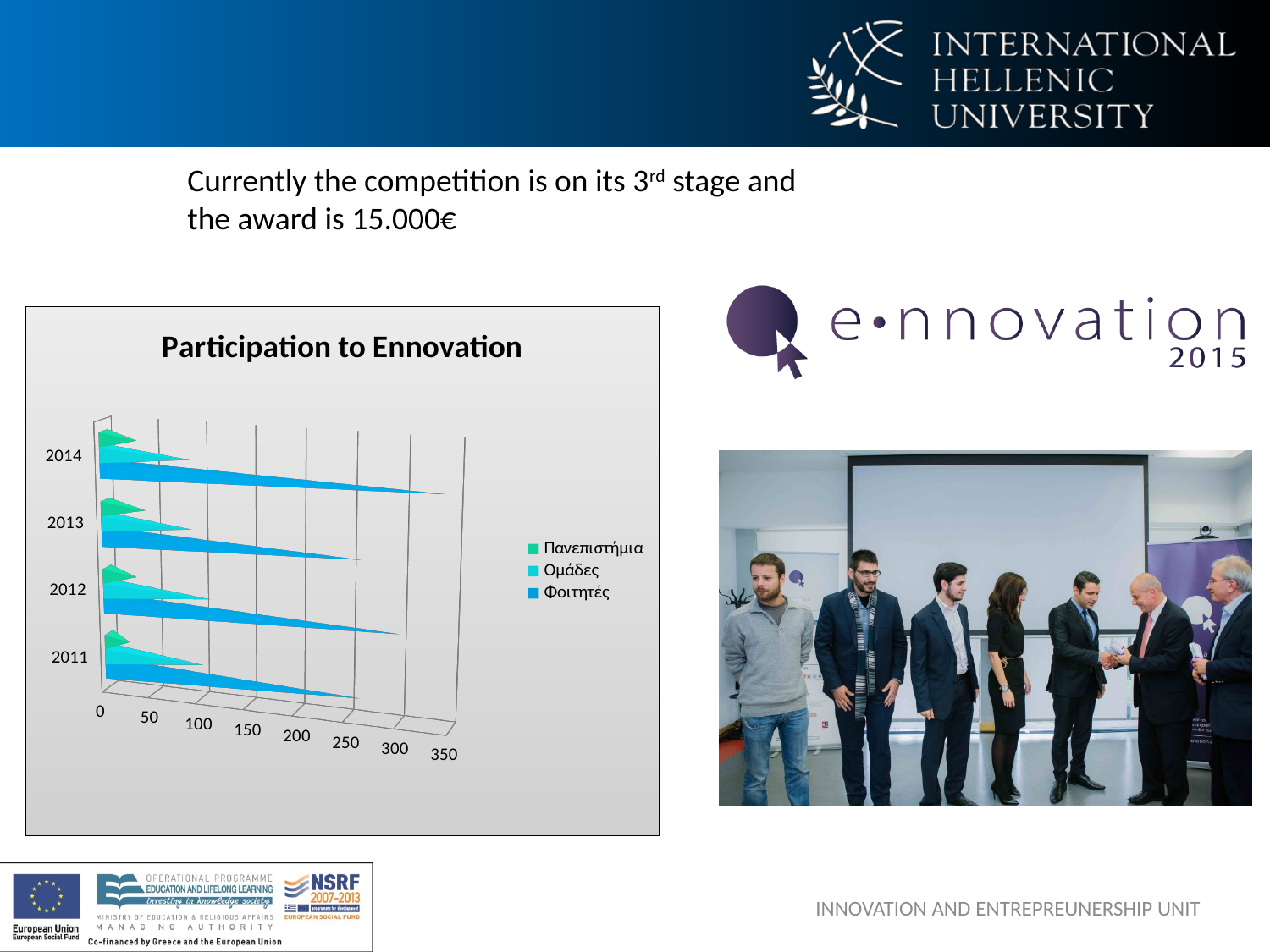
What kind of chart is shown on the slide? bar chart What is the title of the chart? Participation to Ennovation In 2012, which series has the larger value, Φοιτητές or Πανεπιστήμια? Φοιτητές Is the Φοιτητές value for 2011 greater or less than 300? less Is the Πανεπιστήμια value for 2014 greater or less than 50? less Which is larger, the Φοιτητές value for 2014 or for 2011? 2014 Is the Φοιτητές value for 2014 greater or less than 250? greater In which year is the Φοιτητές value highest? 2014 How many years are shown on the chart's vertical axis? 4 Which series are listed in the chart's legend? Πανεπιστήμια, Ομάδες, Φοιτητές How many series does the chart's legend list? 3